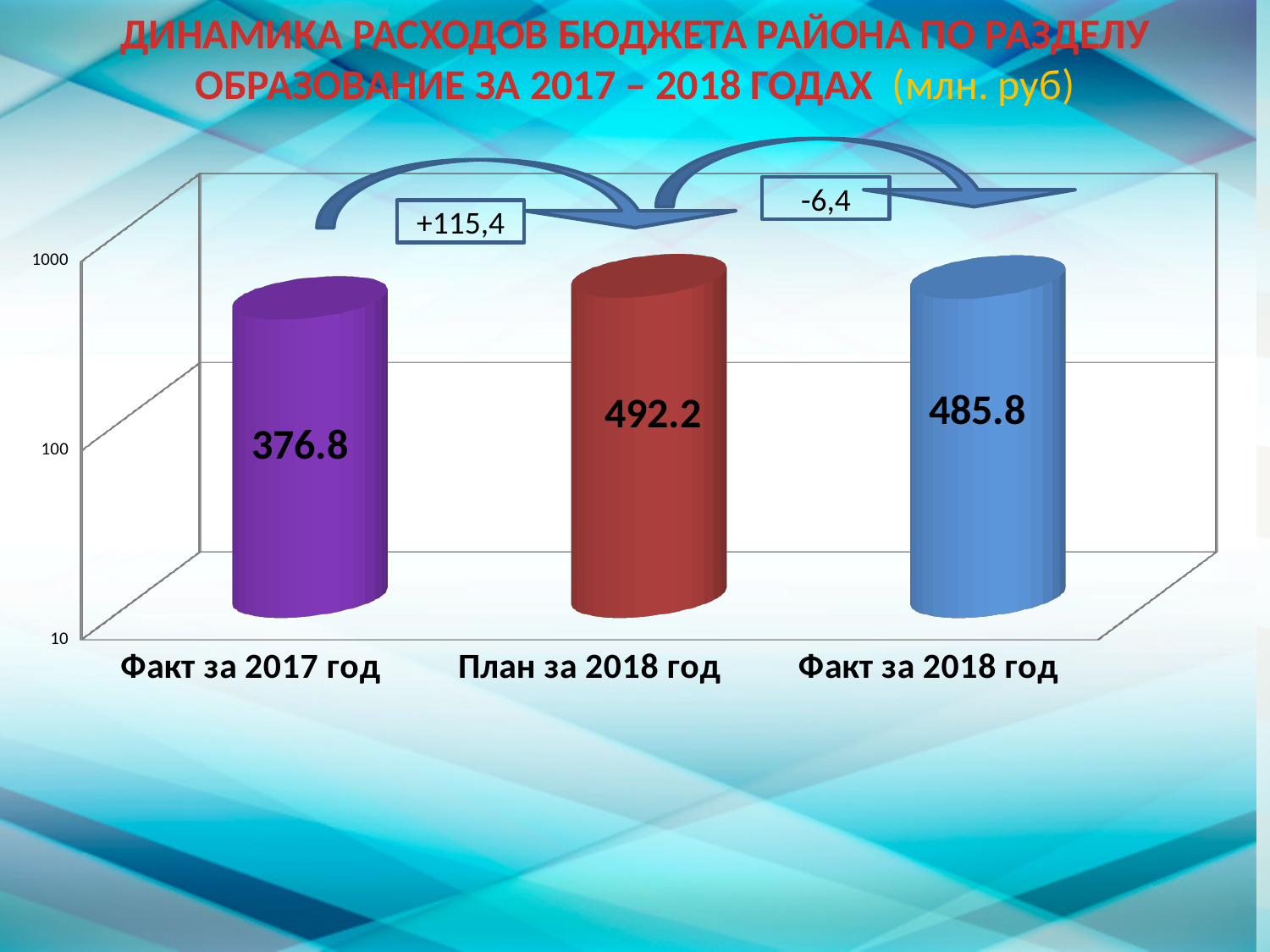
What is the difference between План за 2018 год and Факт за 2017 год? 115.4 Which category has the highest value? План за 2018 год What is the value for Факт за 2017 год? 376.8 What is the value for Факт за 2018 год? 485.8 Is the value for Факт за 2017 год greater or less than 100? greater What colour is the bar for План за 2018 год? red What is the difference between План за 2018 год and Факт за 2018 год? 6.4 Which is larger, Факт за 2018 год or Факт за 2017 год? Факт за 2018 год How many categories are shown on the chart? 3 What is the value for План за 2018 год? 492.2 Which category has the lowest value? Факт за 2017 год What kind of chart is shown on the slide? bar chart